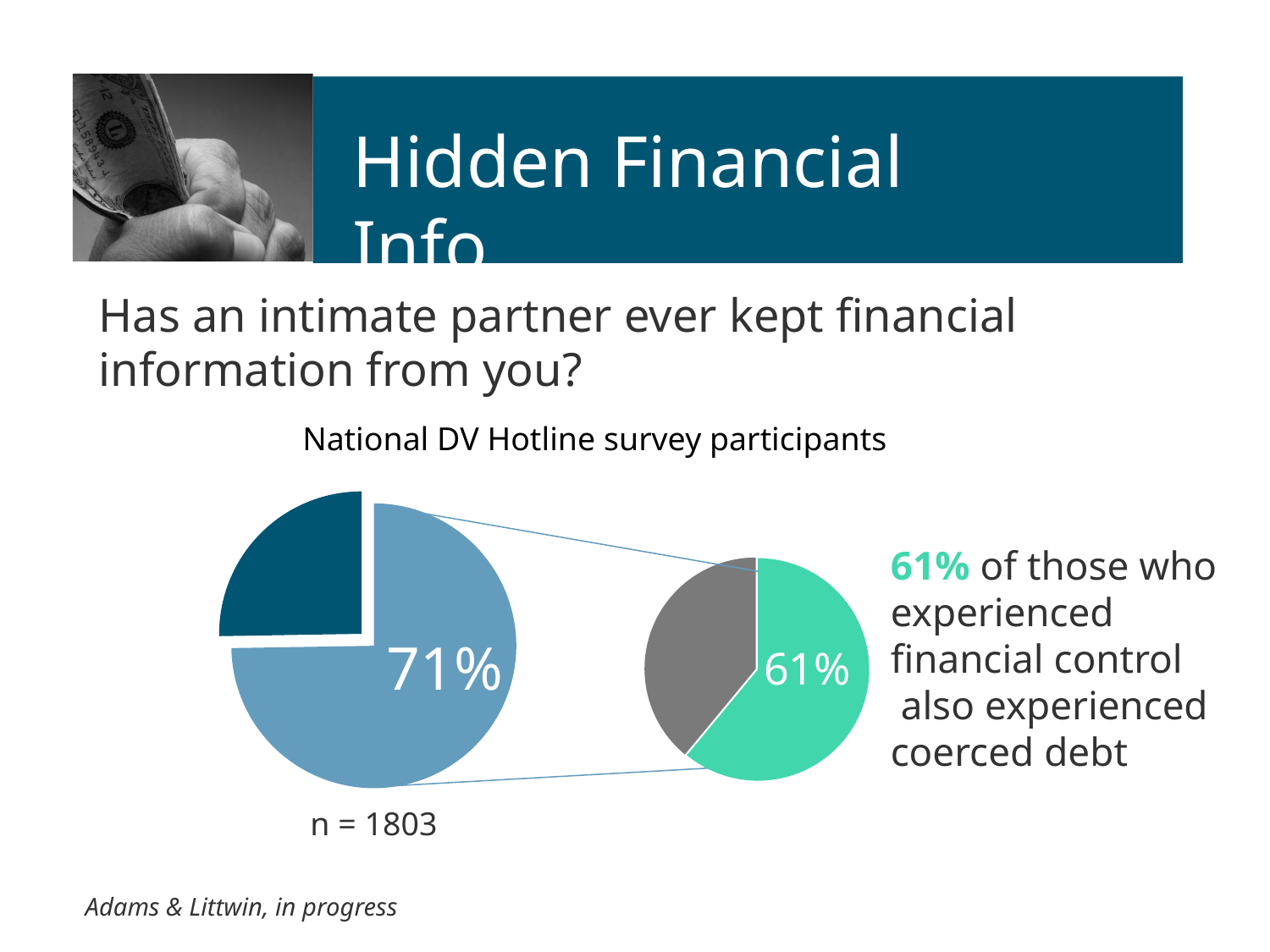
What is the title of the chart? National DV Hotline survey participants What percentage is labelled on the large light blue slice of the main pie? 71% What kind of chart is shown on the slide? Pie chart What is the difference between the 71% labelled on the main pie and the 61% labelled on the smaller pie? 10% What percentage is labelled on the green slice of the smaller pie? 61% How many slices does the main (left) pie have? 2 In the main pie, which slice is larger, the light blue slice or the dark blue slice? The light blue slice What is the sample size (n) shown below the chart? n = 1803 How many slices does the smaller (right) pie have? 2 Is the share of the light blue slice in the main pie greater or less than 50%? greater In the smaller pie, which slice is larger, the green slice or the gray slice? The green slice What share of the main pie does the light blue slice represent? 71%